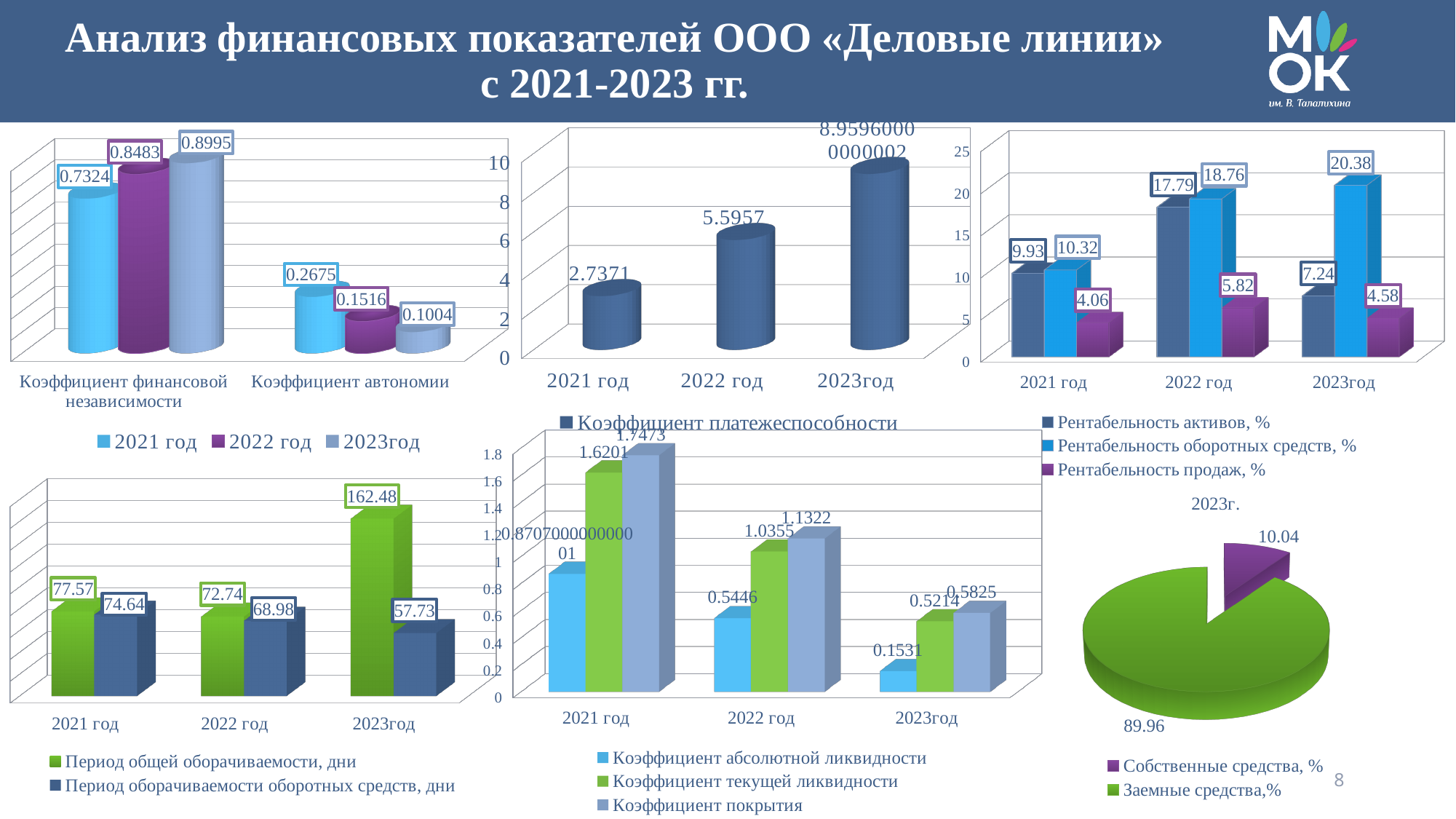
How many series does the legend of the bottom-middle chart list? 3 In the bottom-left chart, which is larger in 2021 год: Период общей оборачиваемости, дни or Период оборачиваемости оборотных средств, дни? Период общей оборачиваемости, дни In the top-left chart, what is the value of Коэффициент финансовой независимости for 2023год? 0.8995 In the chart titled Коэффициент платежеспособности, do the values rise or fall from 2021 год to 2023год? rise In the pie chart titled 2023г., what is the value for Заемные средства,%? 89.96 In the top-right chart, what is the difference between Рентабельность оборотных средств, % and Рентабельность продаж, % in 2022 год? 12.94 In the bottom-middle chart, what is the value of Коэффициент текущей ликвидности for 2022 год? 1.0355 In the chart titled Коэффициент платежеспособности, what is the value for 2022 год? 5.5957 In the bottom-left chart, what is the value of Период общей оборачиваемости, дни for 2023год? 162.48 In the top-right chart, what is the value of Рентабельность оборотных средств, % for 2023год? 20.38 In the top-right chart, which year has the highest value for Рентабельность активов, %? 2022 год In the top-left chart, which year has the lowest value for Коэффициент автономии? 2023год